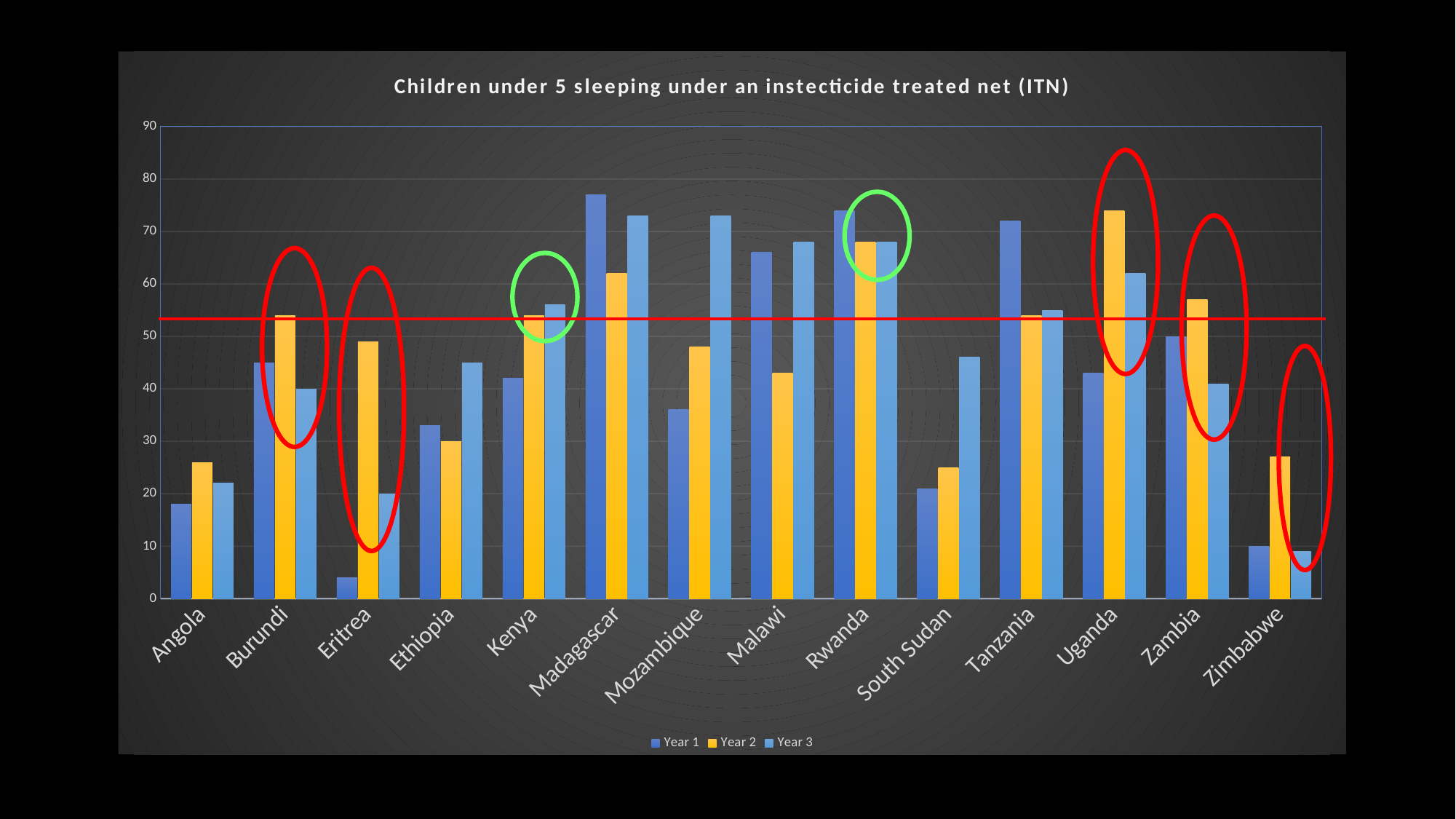
Do the values for Mozambique rise or fall from Year 1 to Year 3? rise For Madagascar, which is larger: the Year 1 value or the Year 2 value? Year 1 Is the Year 2 value for Eritrea greater or less than 40? greater What are the names of the series listed in the legend? Year 1, Year 2, Year 3 Which country has the lowest Year 1 value? Eritrea What is the title of the chart? Children under 5 sleeping under an instecticide treated net (ITN) How many series does the legend list? 3 Which country has the highest Year 2 value? Uganda Which country has the lowest Year 3 value? Zimbabwe How many countries are shown on the x axis of the chart? 14 Is the Year 3 value for Mozambique greater or less than 70? greater What kind of chart is shown on the slide? bar chart